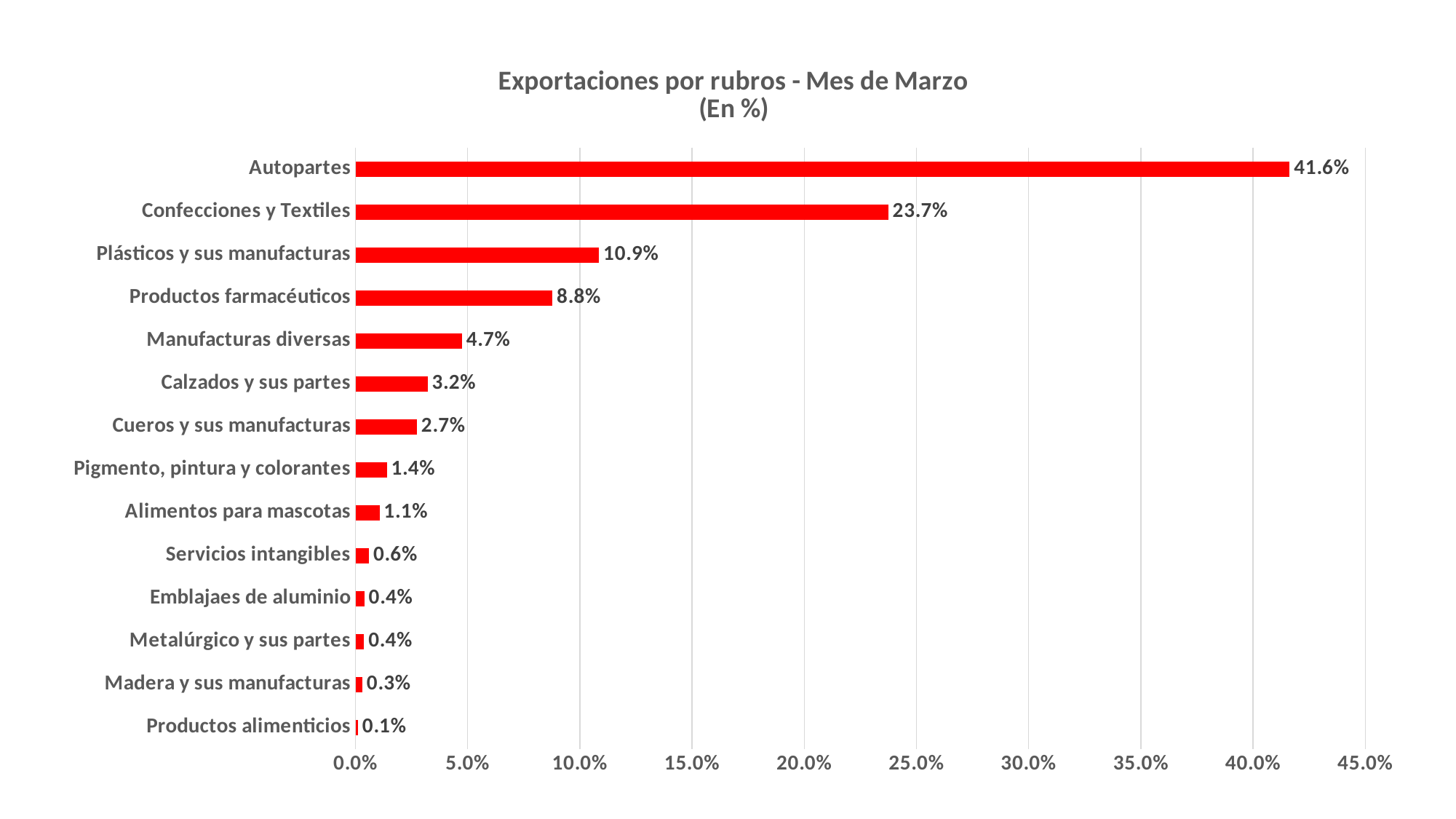
How many categories are shown in the chart? 14 Which category has the highest value? Autopartes What is the difference between Plásticos y sus manufacturas and Productos farmacéuticos? 2.1% What is the title of the chart? Exportaciones por rubros - Mes de Marzo (En %) What is the value for Autopartes? 41.6% Which is larger, Calzados y sus partes or Cueros y sus manufacturas? Calzados y sus partes Is the value for Confecciones y Textiles greater or less than 20.0%? greater Which category has the lowest value? Productos alimenticios What kind of chart is this? Bar chart What is the value for Productos farmacéuticos? 8.8% What is the value for Alimentos para mascotas? 1.1% What is the difference between Autopartes and Confecciones y Textiles? 17.9%